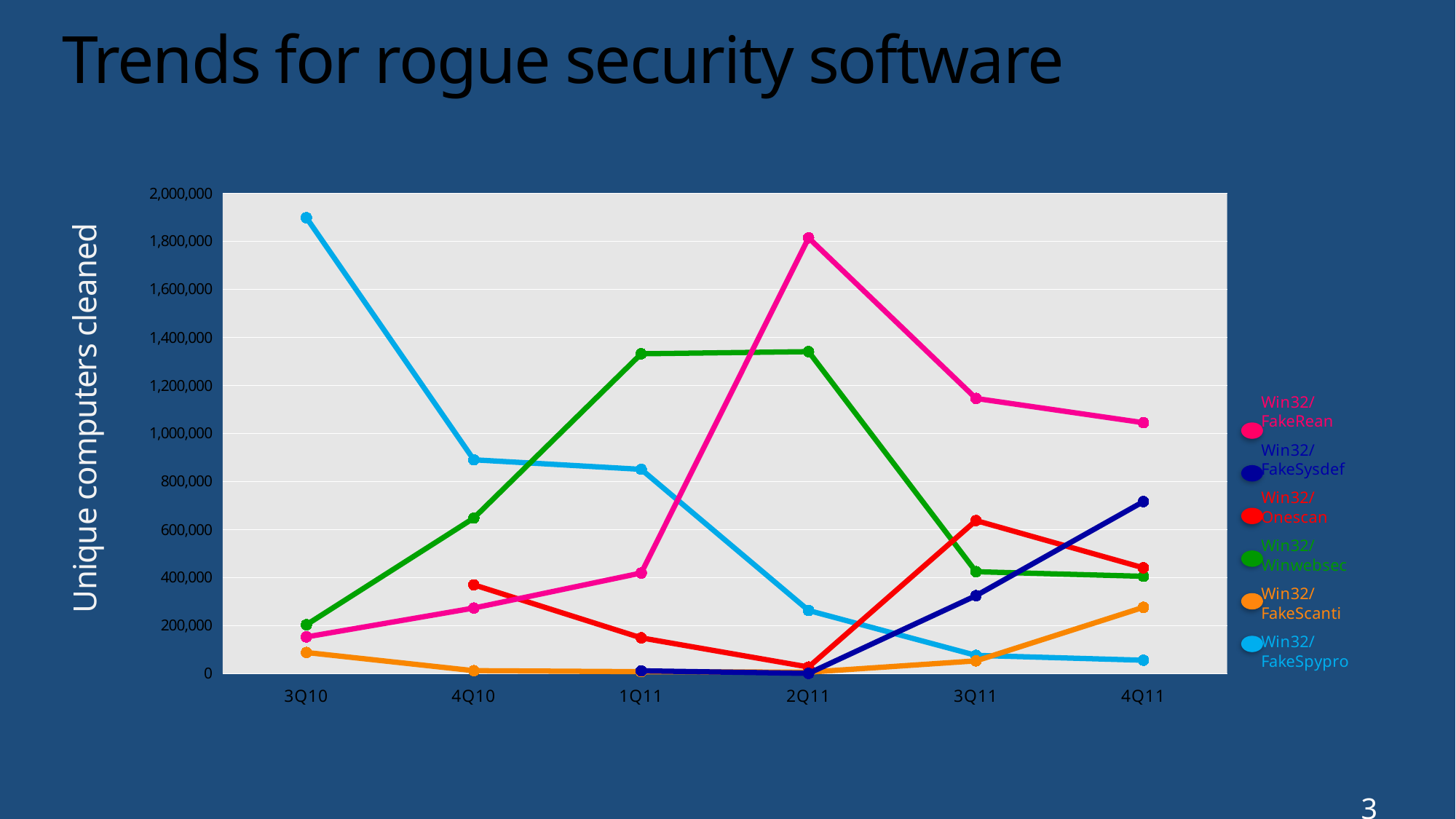
What kind of chart is shown on the slide? line chart What is the label on the y axis? Unique computers cleaned Is the value for Win32/FakeRean in 2Q11 greater or less than 1,600,000? greater Which series has the highest value in 2Q11? Win32/FakeRean In 4Q11, which is larger: Win32/FakeRean or Win32/FakeSysdef? Win32/FakeRean Does the Win32/FakeSpypro line rise or fall from 3Q10 to 4Q11? fall Is the value for Win32/Winwebsec in 1Q11 greater or less than 1,200,000? greater How many series does the legend list? 6 Is the value for Win32/FakeSpypro in 3Q10 greater or less than 1,800,000? greater Which series has the highest value in 3Q10? Win32/FakeSpypro How many quarters are shown along the x axis? 6 Which series has the lowest value in 4Q11? Win32/FakeSpypro